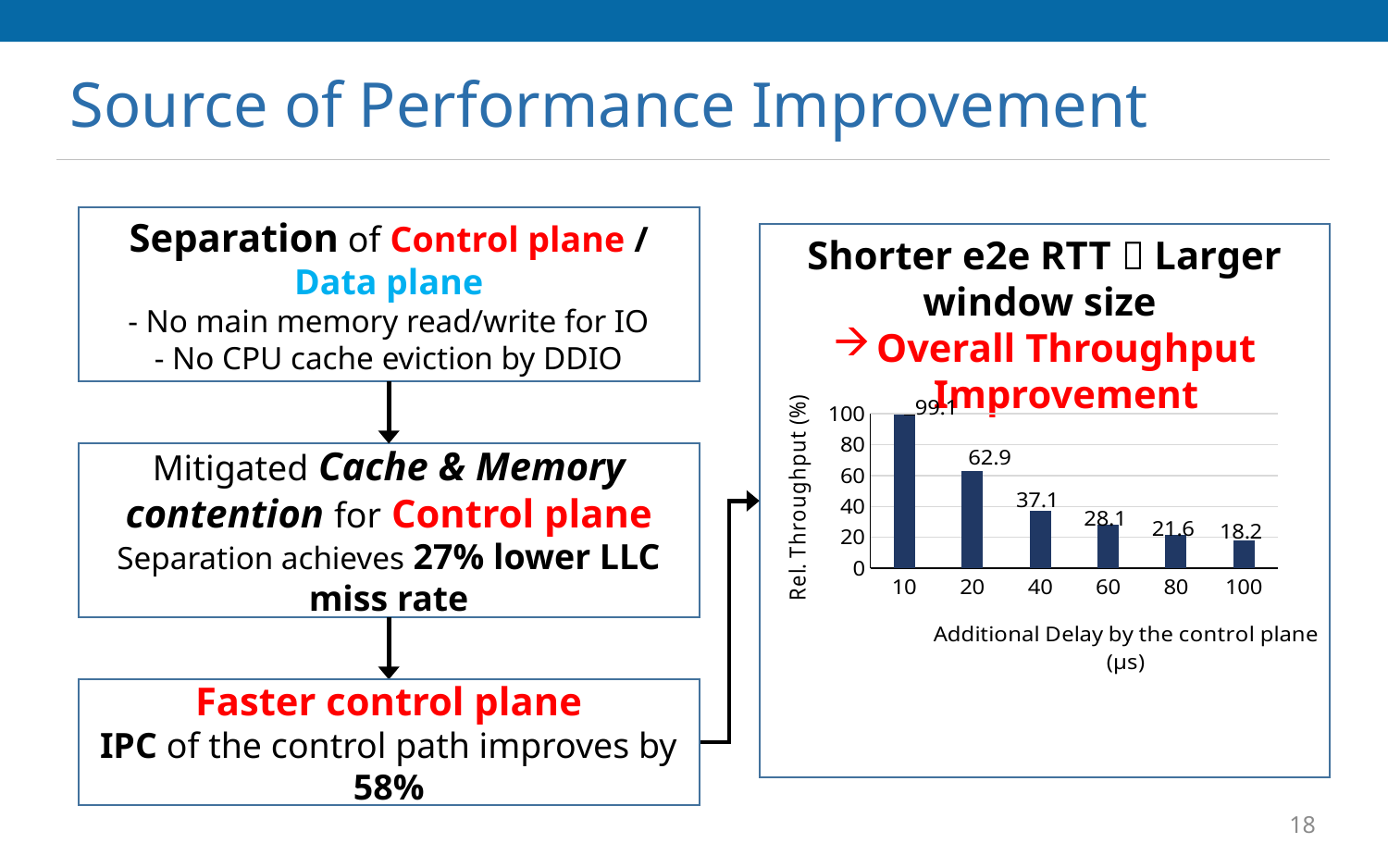
What is the relative throughput (%) at an additional delay of 10 µs? 99.1 Which additional delay value has the highest relative throughput? 10 Which has a larger relative throughput: 20 µs or 80 µs of additional delay? 20 µs What is the difference in relative throughput between 10 µs and 20 µs of additional delay? 36.2 How many additional delay values are plotted in the chart? 6 Does relative throughput rise or fall as additional delay increases along the x axis? fall Is the relative throughput at 20 µs greater or less than 60? greater What is the relative throughput (%) at an additional delay of 40 µs? 37.1 What kind of chart is shown on the slide? bar chart What is the relative throughput (%) at an additional delay of 100 µs? 18.2 What is the relative throughput (%) at an additional delay of 60 µs? 28.1 Which additional delay value has the lowest relative throughput? 100